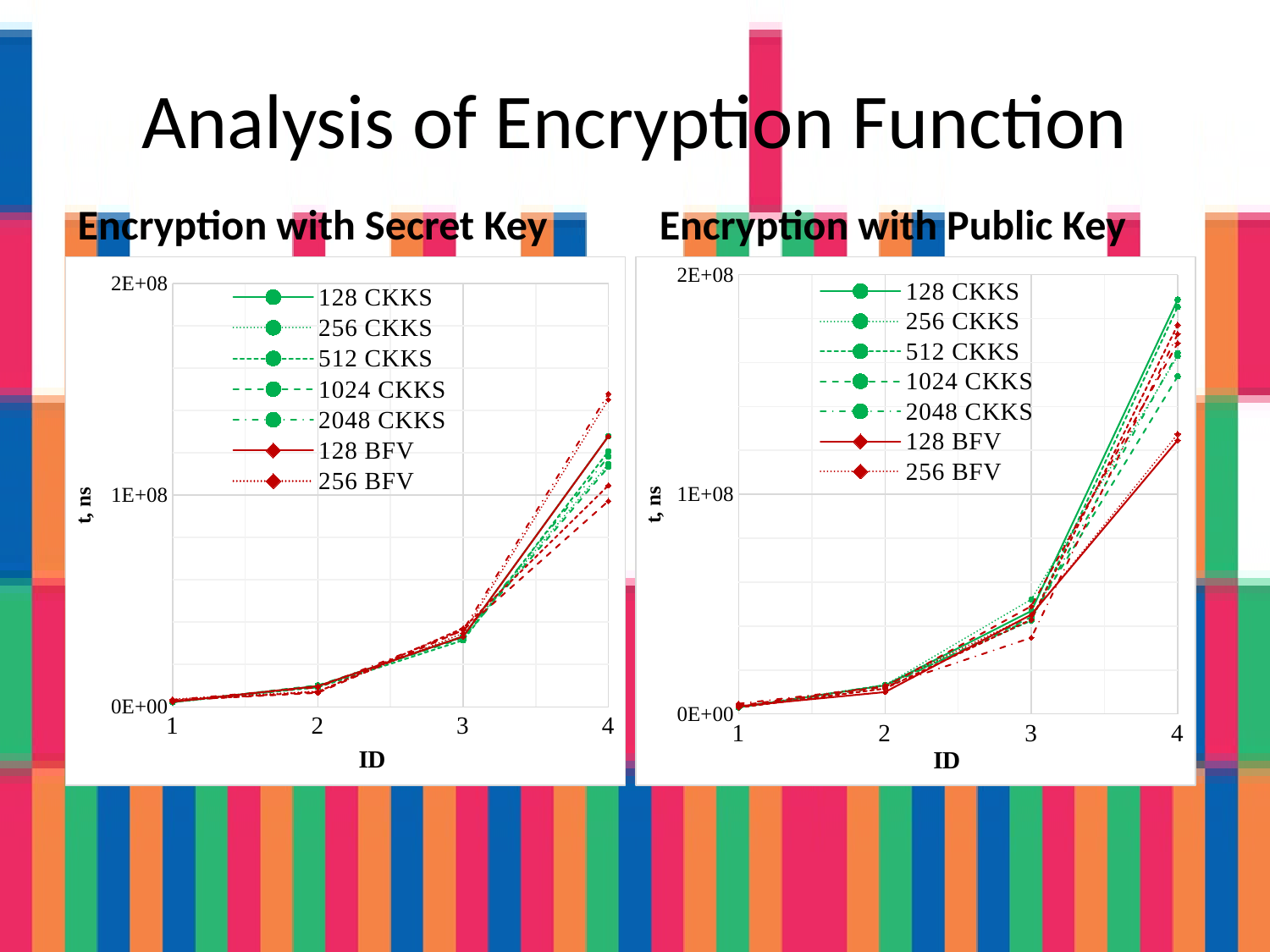
In 'Encryption with Secret Key', do the values rise or fall as ID increases from 1 to 4? rise What is the x-axis label of 'Encryption with Public Key'? ID In 'Encryption with Public Key', is the value for 256 BFV at ID 3 greater or less than 1E+08? less In 'Encryption with Secret Key', is the value for 128 CKKS at ID 3 greater or less than 1E+08? less What type of chart is 'Encryption with Secret Key'? line chart In 'Encryption with Public Key', is the value for 128 CKKS at ID 4 greater or less than 2E+08? less What is the y-axis label of 'Encryption with Secret Key'? t, ns How many ID values are plotted along the x axis of 'Encryption with Secret Key'? 4 In 'Encryption with Public Key', do the values rise or fall as ID increases from 1 to 4? rise How many series does the legend of 'Encryption with Public Key' list? 7